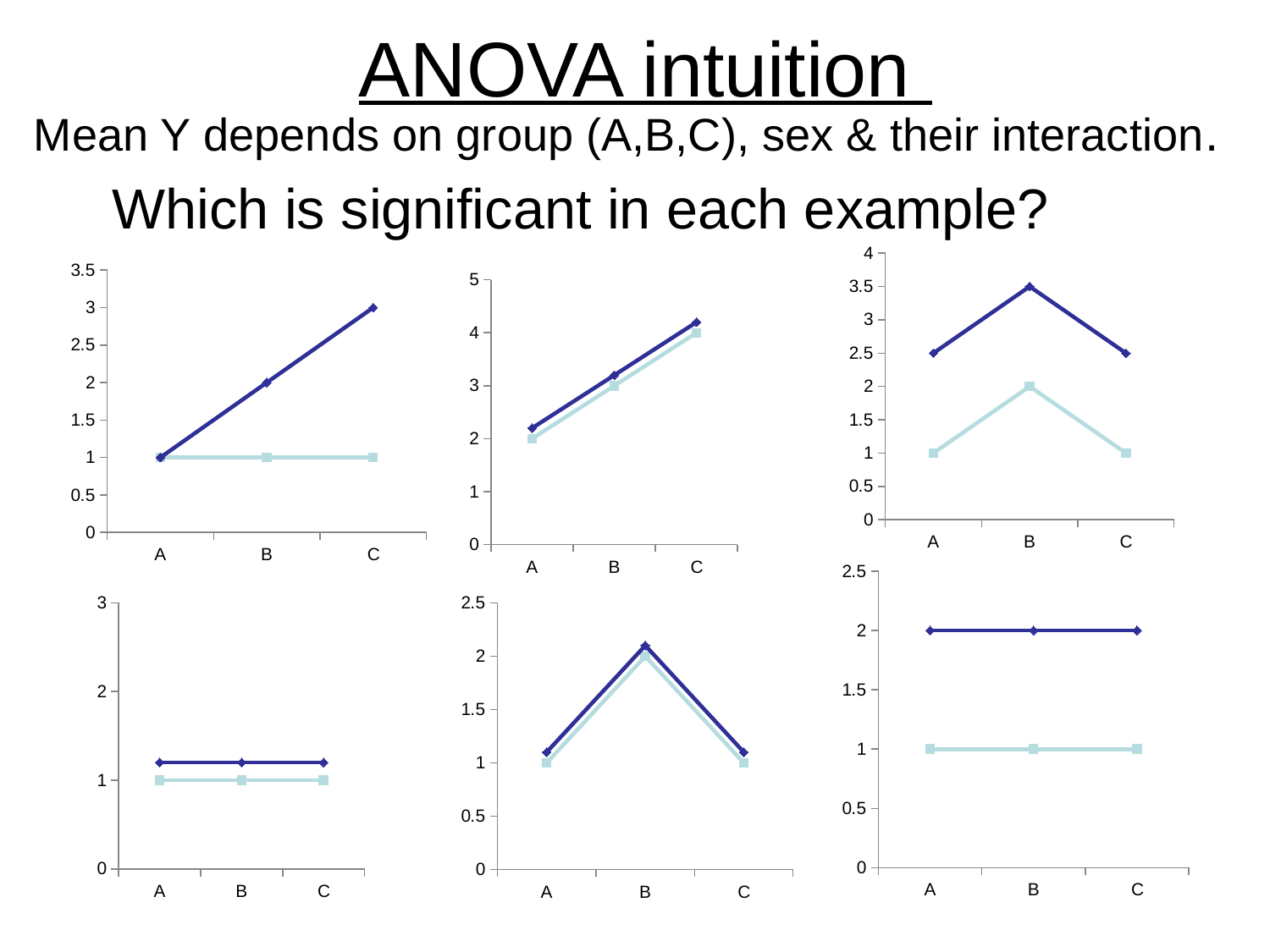
In the top-right chart, what is the value of the light blue line at category B? 2 In the top-left chart, what is the value of the dark blue line at category C? 3 In the top-right chart, what is the value of the dark blue line at category B? 3.5 In the top-middle chart, what is the value of the light blue line at category C? 4 In the bottom-right chart, what is the value of the dark blue line at category B? 2 How many categories are shown on the x axis of the bottom-right chart? 3 In the top-left chart, what is the value of the light blue line at category B? 1 In the top-right chart, at which category does the dark blue line reach its highest value? B In the top-middle chart, does the light blue line rise or fall from A to C? rise In the top-left chart, what is the difference between the dark blue line's values at C and at A? 2 What kind of chart is the top-left chart on the slide? line chart In the bottom-left chart, is the value of the dark blue line at category A greater or less than 2? less